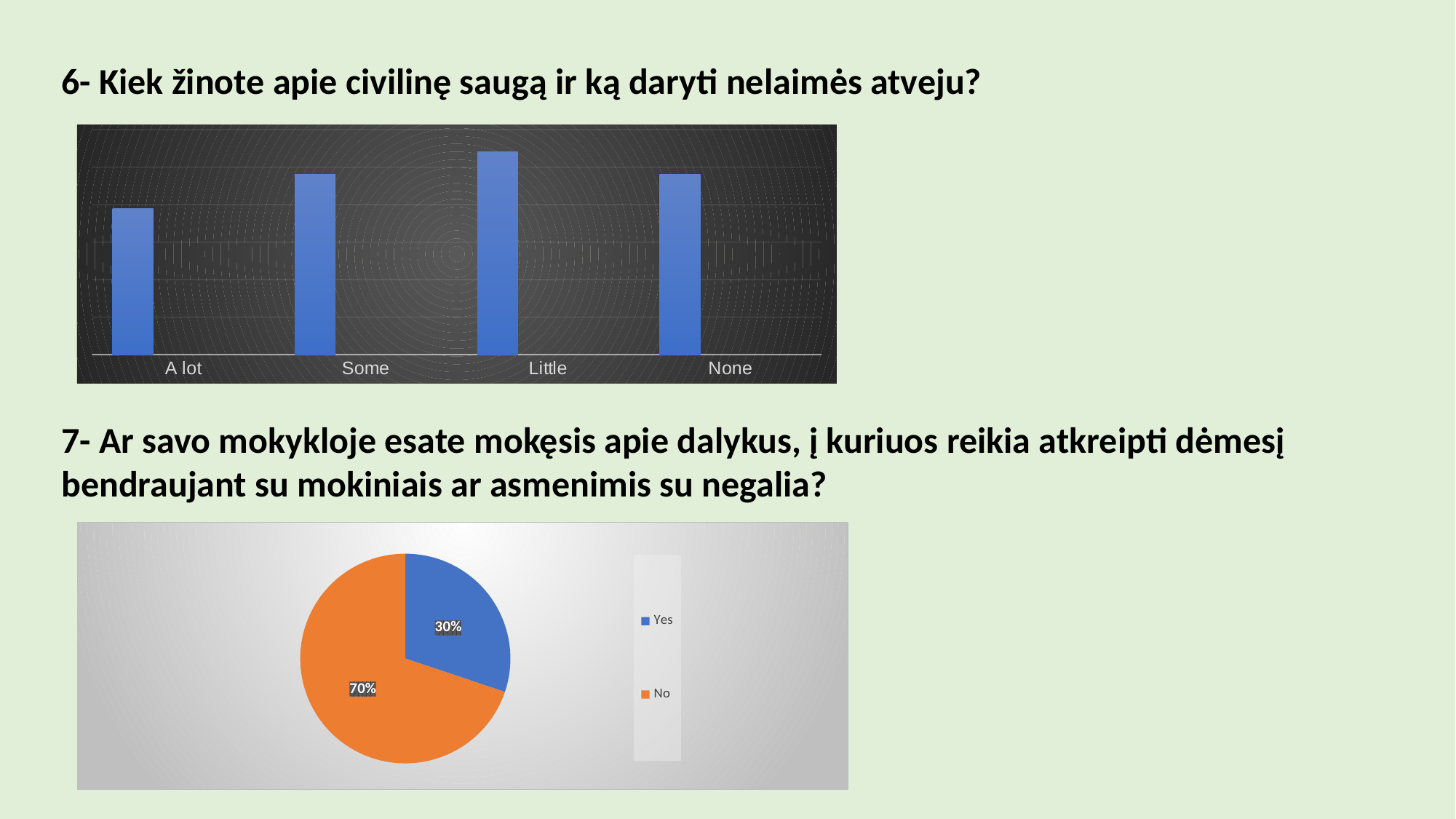
In the bar chart for question 6, which category has the highest bar? Little In the bar chart for question 6, which is larger, the bar for Little or the bar for A lot? Little In the pie chart for question 7, what share of responses is Yes? 30% In the pie chart for question 7, what is the difference between the No share and the Yes share? 40% What kind of chart is used for question 6? bar chart In the pie chart for question 7, which response has the larger share? No What kind of chart is used for question 7? pie chart In the pie chart for question 7, what share of responses is No? 70% How many categories are shown in the bar chart for question 6? 4 In the pie chart for question 7, which colour represents No? orange In the bar chart for question 6, which category has the lowest bar? A lot How many slices does the pie chart for question 7 have? 2